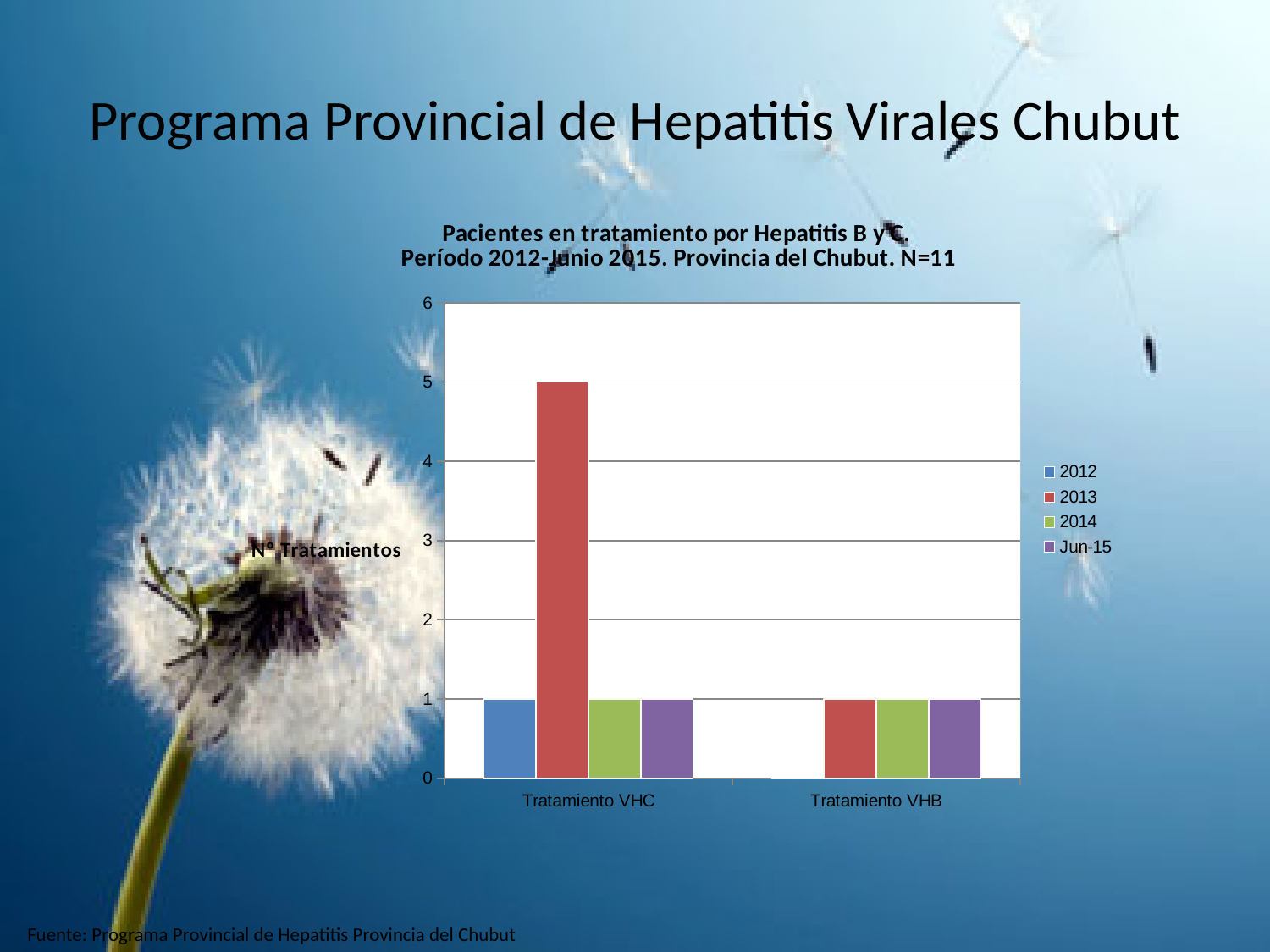
Which is larger: the 2013 value for Tratamiento VHC or the 2014 value for Tratamiento VHC? 2013 value for Tratamiento VHC What is the value for 2012 in the Tratamiento VHC category? 1 Which series has the highest value in the Tratamiento VHC category? 2013 Which series has no visible bar in the Tratamiento VHB category? 2012 What is the value for 2013 in the Tratamiento VHC category? 5 What is the title of the chart? Pacientes en tratamiento por Hepatitis B y C. Período 2012-Junio 2015. Provincia del Chubut. N=11 What kind of chart is shown on the slide? Bar chart What is the difference between the 2013 value for Tratamiento VHC and the 2013 value for Tratamiento VHB? 4 What is the value for Jun-15 in the Tratamiento VHB category? 1 How many categories are shown on the x axis? 2 Is the value for 2013 in the Tratamiento VHC category greater or less than 4? greater How many series does the legend list? 4